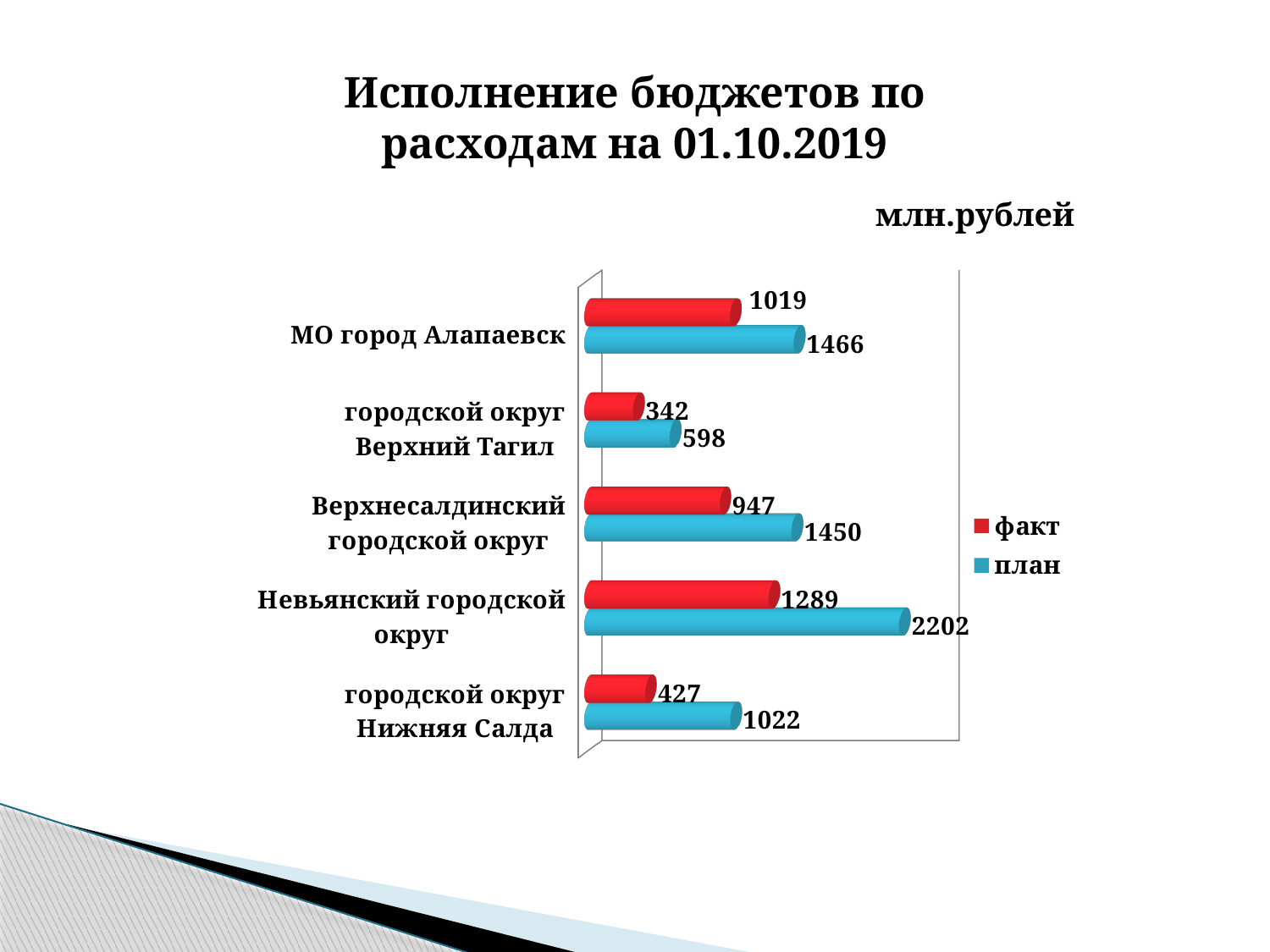
Which category has the highest план value? Невьянский городской округ What unit is indicated above the chart? млн.рублей Which is larger, the факт value for МО город Алапаевск or the факт value for Верхнесалдинский городской округ? МО город Алапаевск How many series does the legend list? 2 What is the факт value for МО город Алапаевск? 1019 How many categories are shown on the chart? 5 What is the difference between the план and факт values for городской округ Нижняя Салда? 595 What is the план value for городской округ Верхний Тагил? 598 What kind of chart is shown on the slide? bar chart What is the difference between the план and факт values for Верхнесалдинский городской округ? 503 What is the план value for Невьянский городской округ? 2202 Which category has the lowest факт value? городской округ Верхний Тагил